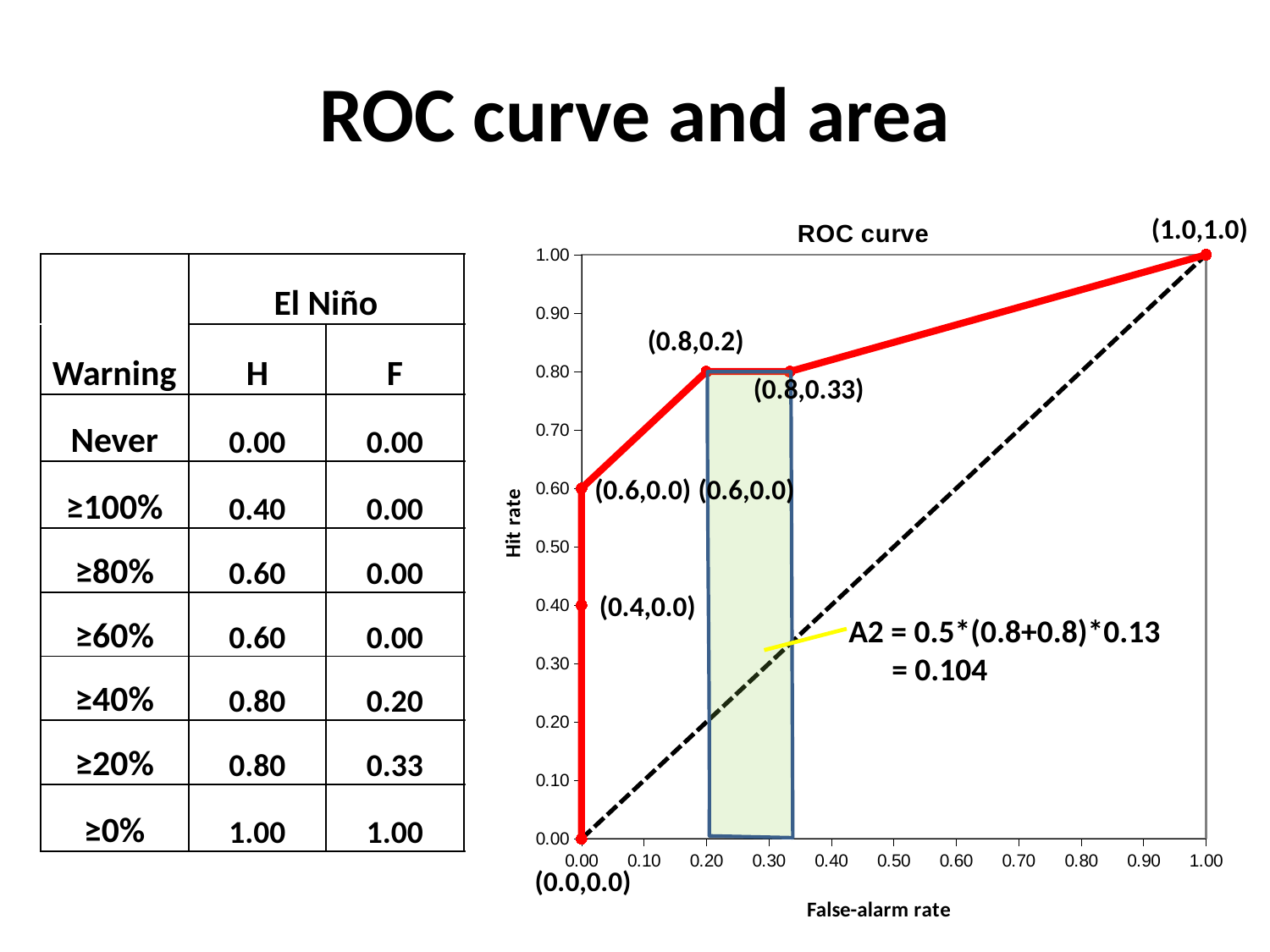
Which is larger: the hit rate at the point labelled (0.8,0.2) or the hit rate at the point labelled (0.6,0.0)? (0.8,0.2) Is the hit rate at a false-alarm rate of 0.20 greater or less than 0.70? greater What kind of chart is shown on the slide? line chart What value of A2 is given in the annotation on the chart? 0.104 What is the title of the chart? ROC curve What is the label of the x axis of the chart? False-alarm rate According to the point label on the chart, what is the hit rate when the false-alarm rate is 0.2? 0.8 Does the hit rate on the ROC curve rise or fall as the false-alarm rate increases? rise What width value is multiplied in the A2 formula shown on the chart? 0.13 What is the difference between the hit rate at the point (1.0,1.0) and the hit rate at the point labelled (0.8,0.2)? 0.2 What is the highest hit rate reached by the ROC curve? 1.0 According to the point label on the chart, what is the hit rate when the false-alarm rate is 0.33? 0.8